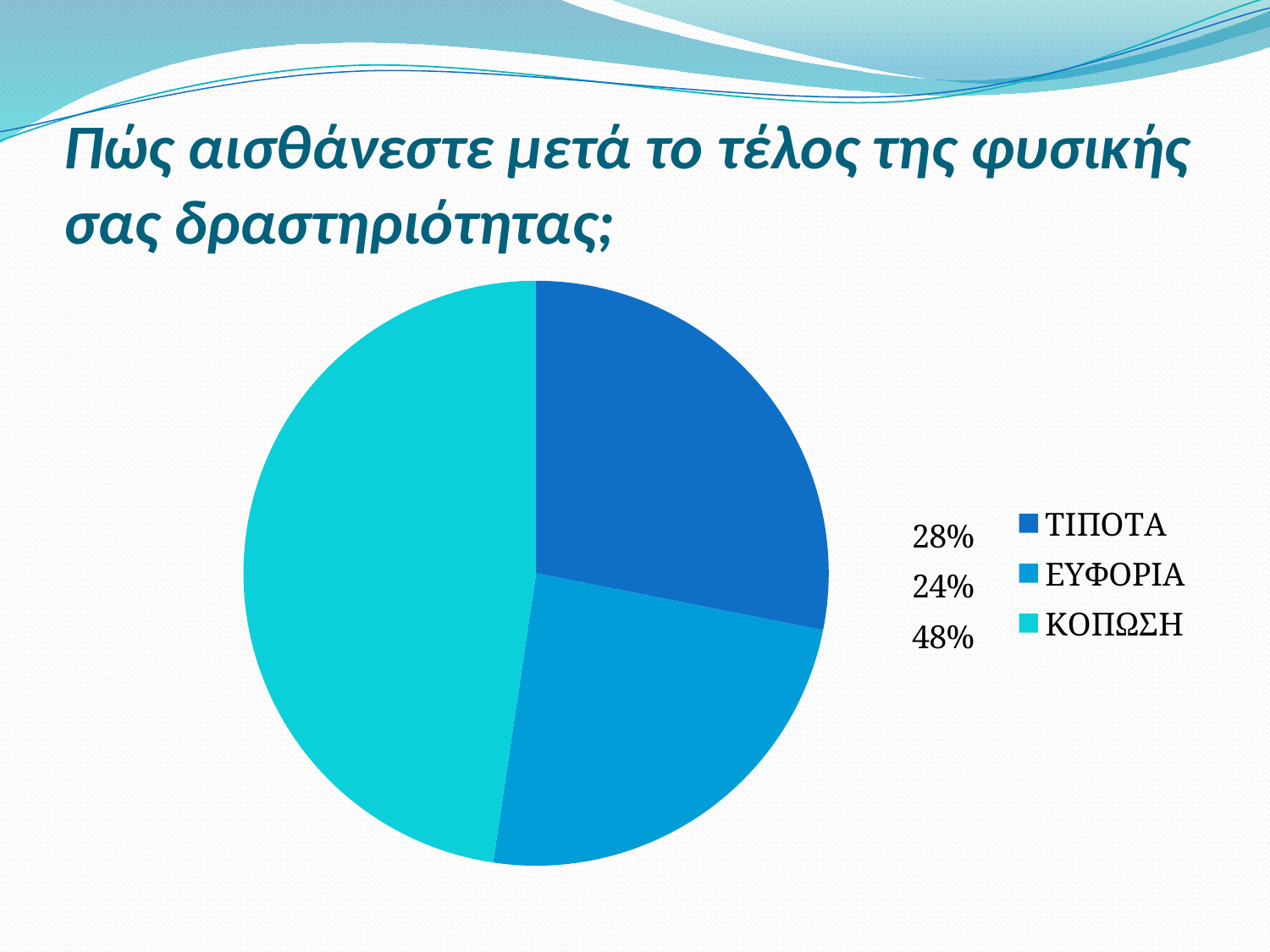
Which is larger, the share for ΤΙΠΟΤΑ or the share for ΕΥΦΟΡΙΑ? ΤΙΠΟΤΑ What is the combined percentage of ΤΙΠΟΤΑ and ΕΥΦΟΡΙΑ? 52% What is the difference in percentage points between ΚΟΠΩΣΗ and ΤΙΠΟΤΑ? 20 What percentage is shown for ΕΥΦΟΡΙΑ? 24% Which category is shown in the lightest (cyan) colour in the pie chart? ΚΟΠΩΣΗ What is the title of the slide containing the pie chart? Πώς αισθάνεστε μετά το τέλος της φυσικής σας δραστηριότητας; What percentage is shown for ΤΙΠΟΤΑ? 28% What kind of chart is shown on the slide? pie chart Which category has the largest share of the pie? ΚΟΠΩΣΗ How many categories does the legend of the pie chart list? 3 Which category has the smallest share of the pie? ΕΥΦΟΡΙΑ What percentage is shown for ΚΟΠΩΣΗ? 48%